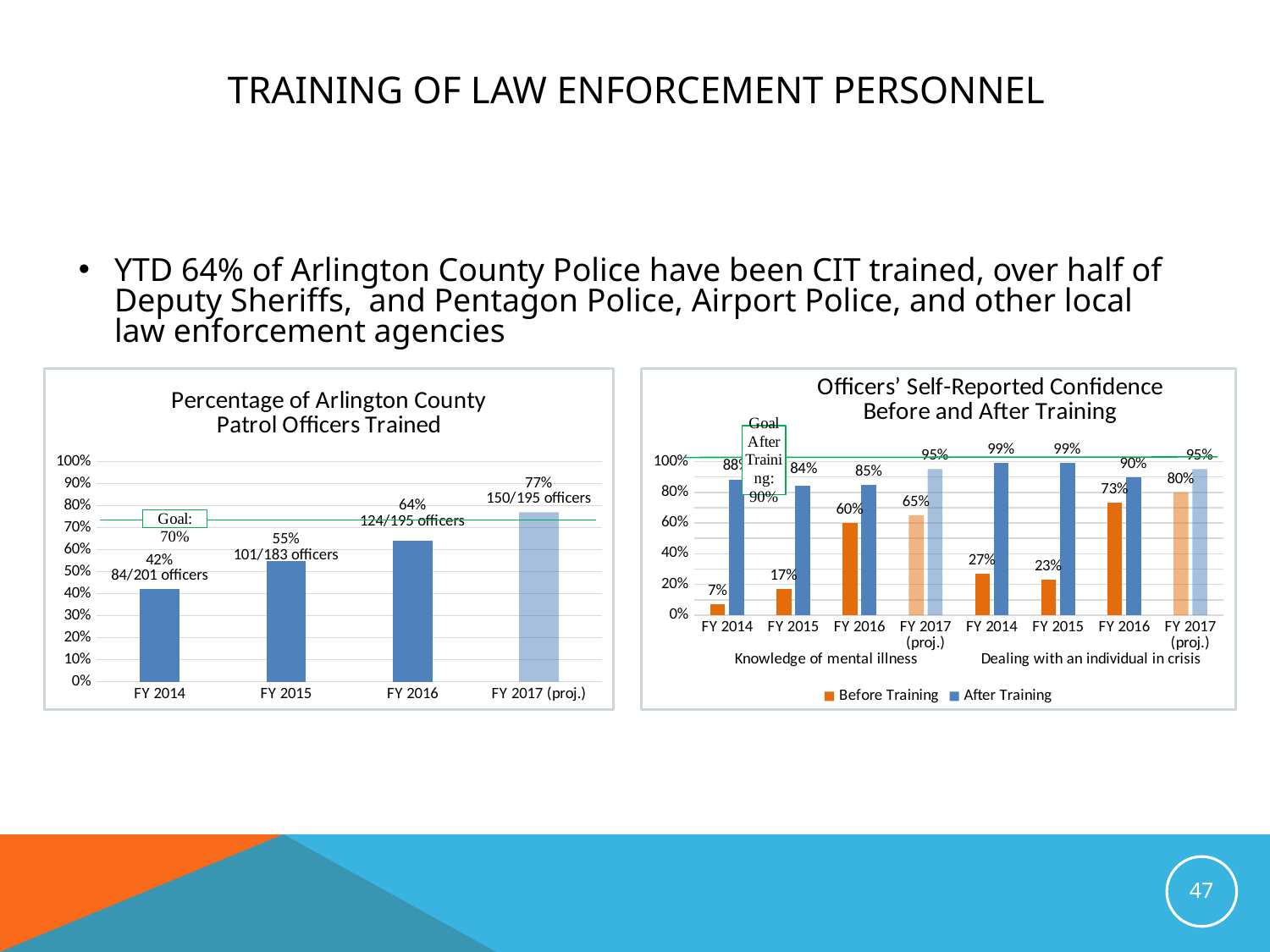
In the 'Percentage of Arlington County Patrol Officers Trained' chart, which fiscal year has the highest percentage trained? FY 2017 (proj.) In the 'Percentage of Arlington County Patrol Officers Trained' chart, do the values rise or fall from FY 2014 to FY 2017 (proj.)? Rise In the 'Officers' Self-Reported Confidence Before and After Training' chart, how many series does the legend list? 2 In the 'Percentage of Arlington County Patrol Officers Trained' chart, how many officers out of the total were trained in FY 2014? 84/201 officers In the 'Percentage of Arlington County Patrol Officers Trained' chart, what goal percentage is marked by the horizontal line? 70% In the 'Officers' Self-Reported Confidence Before and After Training' chart, what was the Before Training value for Knowledge of mental illness in FY 2014? 7% In the 'Percentage of Arlington County Patrol Officers Trained' chart, what percentage of patrol officers were trained in FY 2015? 55% What type of chart is the 'Officers' Self-Reported Confidence Before and After Training' chart? Bar chart In the 'Officers' Self-Reported Confidence Before and After Training' chart, what was the After Training value for Dealing with an individual in crisis in FY 2016? 90% In the 'Officers' Self-Reported Confidence Before and After Training' chart, which is larger for Knowledge of mental illness in FY 2016: the Before Training value or the After Training value? After Training In the 'Officers' Self-Reported Confidence Before and After Training' chart, what is the difference between the Before Training and After Training values for Dealing with an individual in crisis in FY 2015? 76 percentage points In the 'Percentage of Arlington County Patrol Officers Trained' chart, what is the difference in percentage points between FY 2016 and FY 2014? 22 percentage points